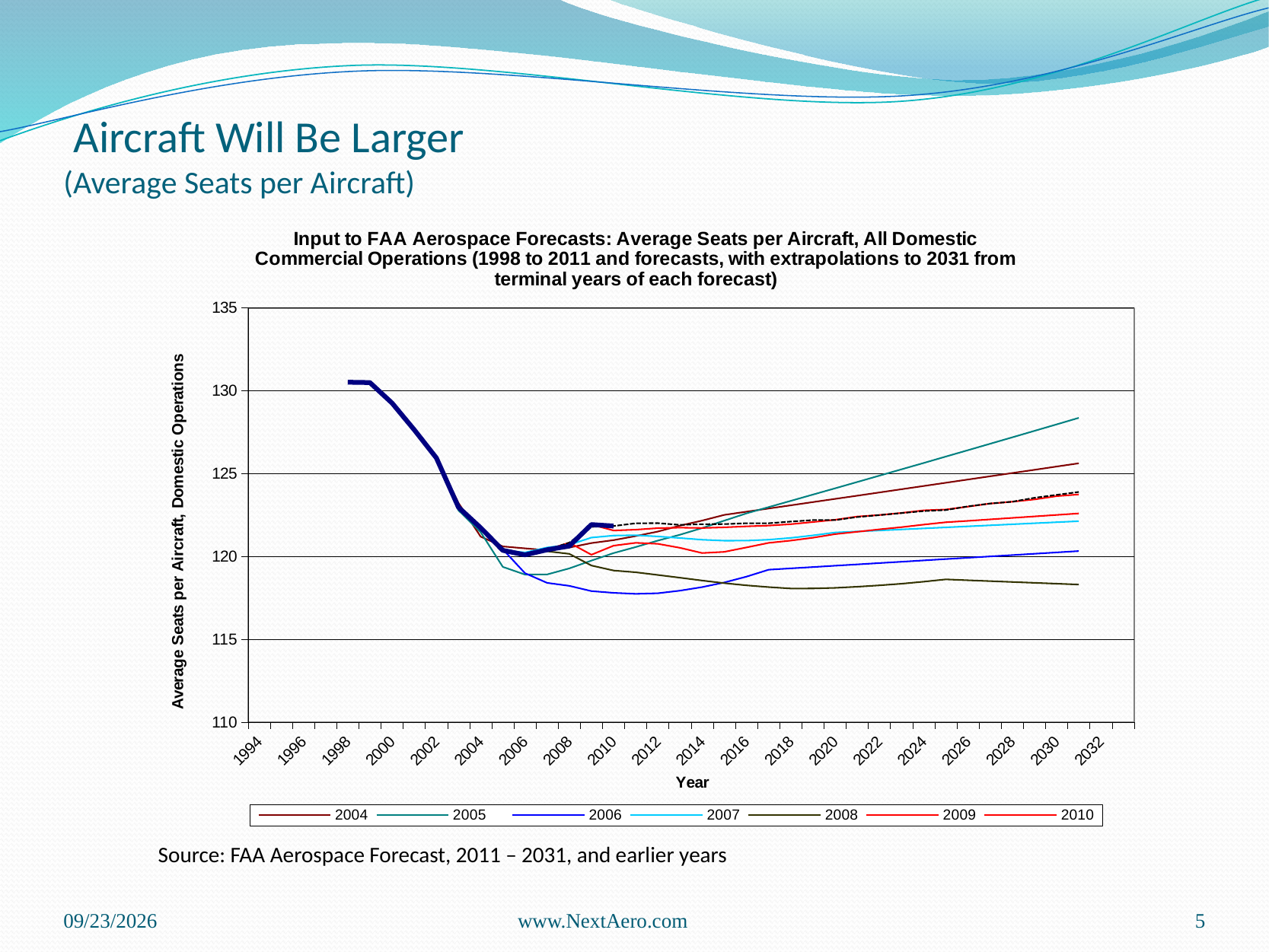
At the right end of the chart (around 2031), which series is larger, 2005 or 2006? 2005 Is the value of the 2008 series at the right end of the chart (around 2031) greater or less than 120? less What is the label on the horizontal axis of the chart? Year How many series does the chart legend list? 7 What is the label on the vertical axis of the chart? Average Seats per Aircraft, Domestic Operations Which series in the legend reaches the highest value at the right end of the chart (around 2031)? 2005 Is the value of the 2006 series around 2012 greater or less than 120? less What kind of chart is shown on the slide? Line chart Does the 2005 series rise or fall from 2010 to 2031? Rise Which series in the legend has the lowest value at the right end of the chart (around 2031)? 2008 Is the value of the 2004 series at the right end of the chart (around 2031) greater or less than 120? greater